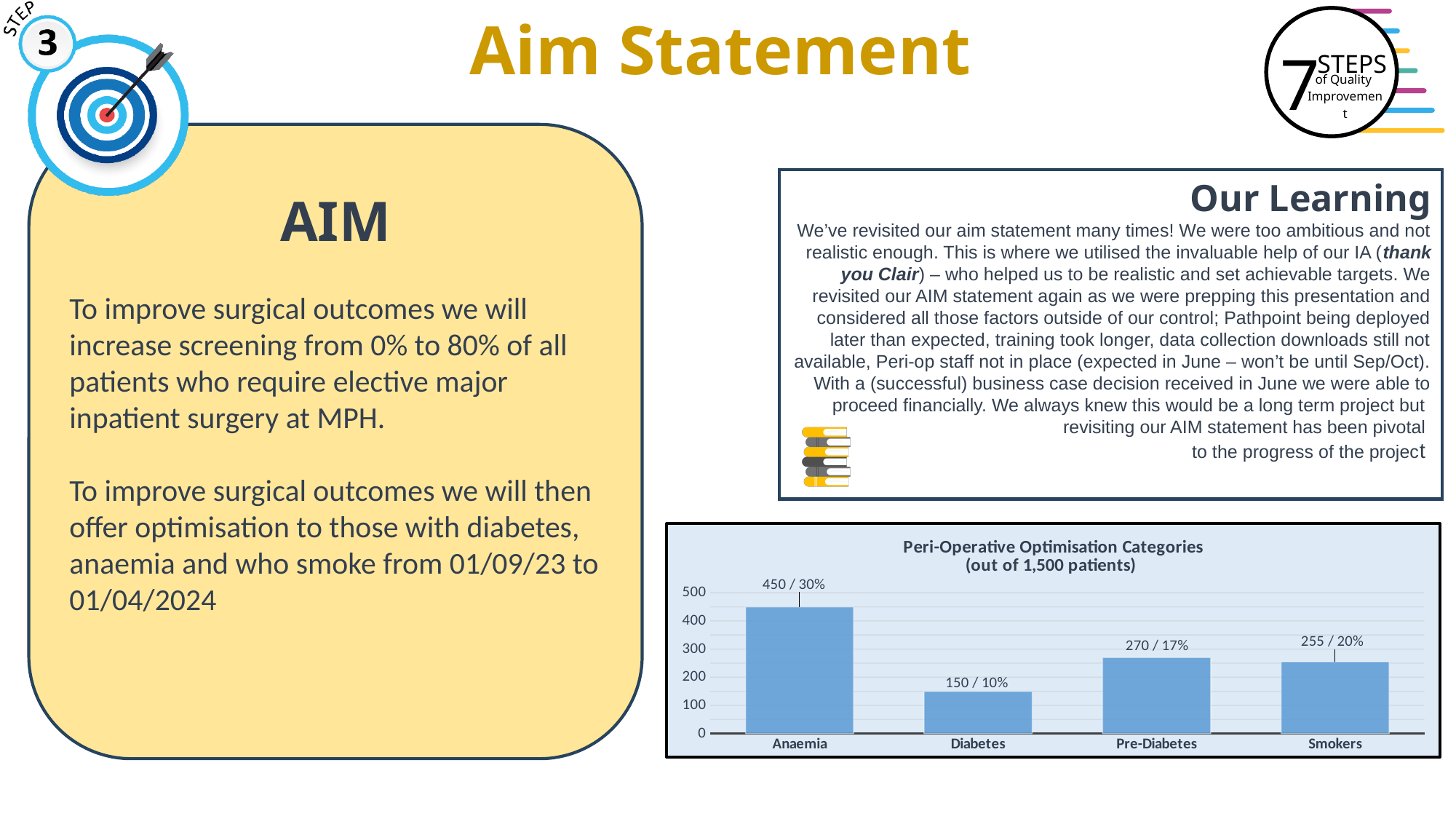
Which category has the highest value in the chart? Anaemia Which has a larger number of patients, Pre-Diabetes or Smokers? Pre-Diabetes What is the data label shown for Smokers in the chart? 255 / 20% What type of chart is shown on the slide? Bar chart Is the value for Smokers greater or less than 200? greater How many categories are shown in the chart? 4 What is the difference between the number of patients for Anaemia and Diabetes? 300 What is the title of the chart? Peri-Operative Optimisation Categories (out of 1,500 patients) What is the data label shown for Pre-Diabetes in the chart? 270 / 17% Which category has the lowest value in the chart? Diabetes What is the data label shown for Diabetes in the chart? 150 / 10% What is the data label shown for Anaemia in the Peri-Operative Optimisation Categories chart? 450 / 30%